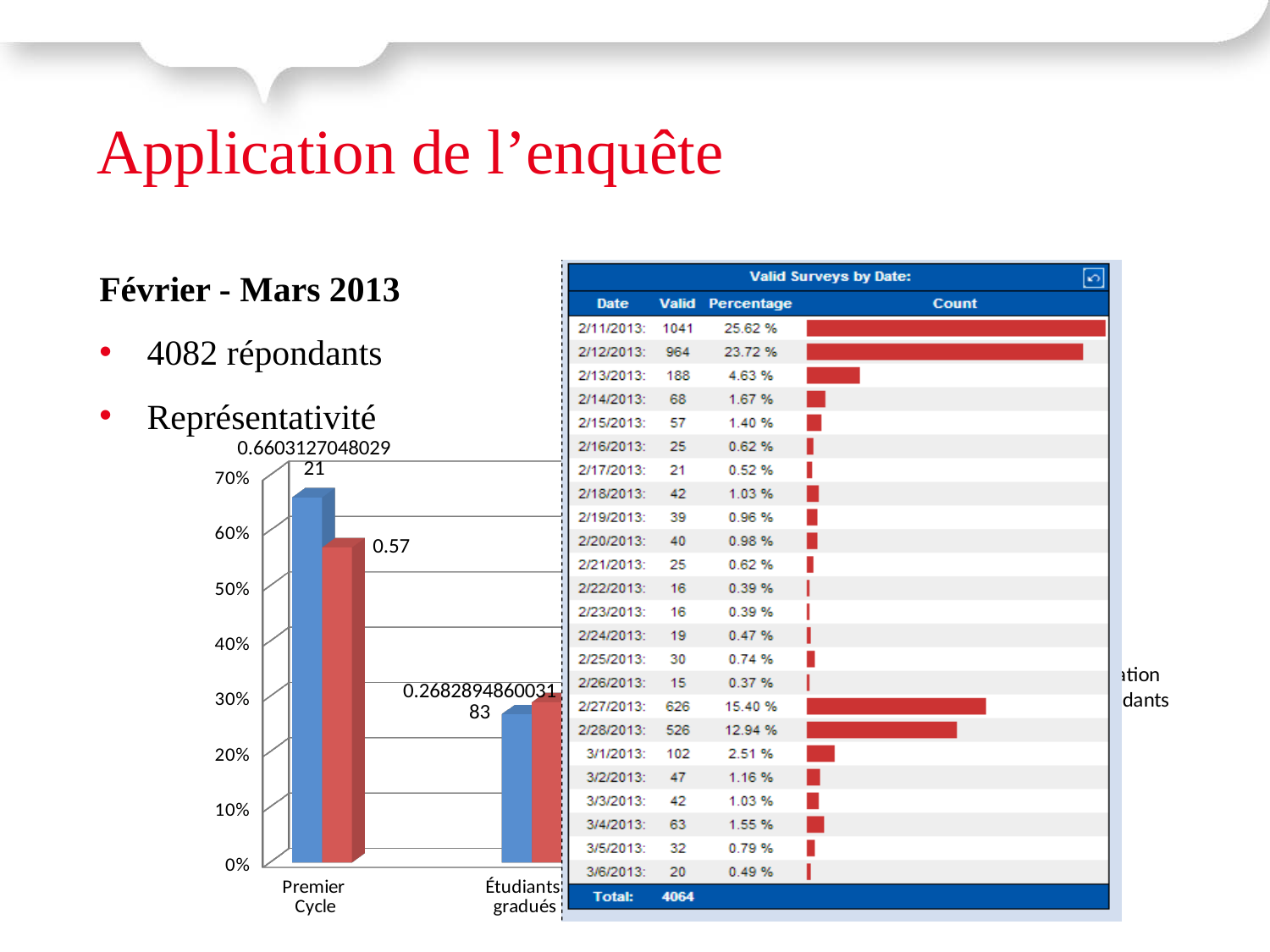
In the 'Valid Surveys by Date' chart, what is the Valid count for 2/27/2013? 626 What kind of chart is the chart on the left with the categories Premier Cycle and Étudiants gradués? bar chart In the left bar chart, what is the value of the red bar for Premier Cycle? 0.57 In the 'Valid Surveys by Date' chart, what is the Percentage for 2/12/2013? 23.72 % In the left bar chart, is the value of the blue bar for Premier Cycle greater or less than 60%? greater In the left bar chart, what is the value of the blue bar for Premier Cycle? 0.660312704802921 In the 'Valid Surveys by Date' chart, which date has the highest count? 2/11/2013 In the left bar chart, which category has the larger blue bar, Premier Cycle or Étudiants gradués? Premier Cycle In the left bar chart, is the value of the blue bar for Étudiants gradués greater or less than 30%? less In the 'Valid Surveys by Date' chart, what is the difference between the Valid counts for 2/11/2013 and 2/12/2013? 77 In the 'Valid Surveys by Date' chart, which date has the lowest count? 2/26/2013